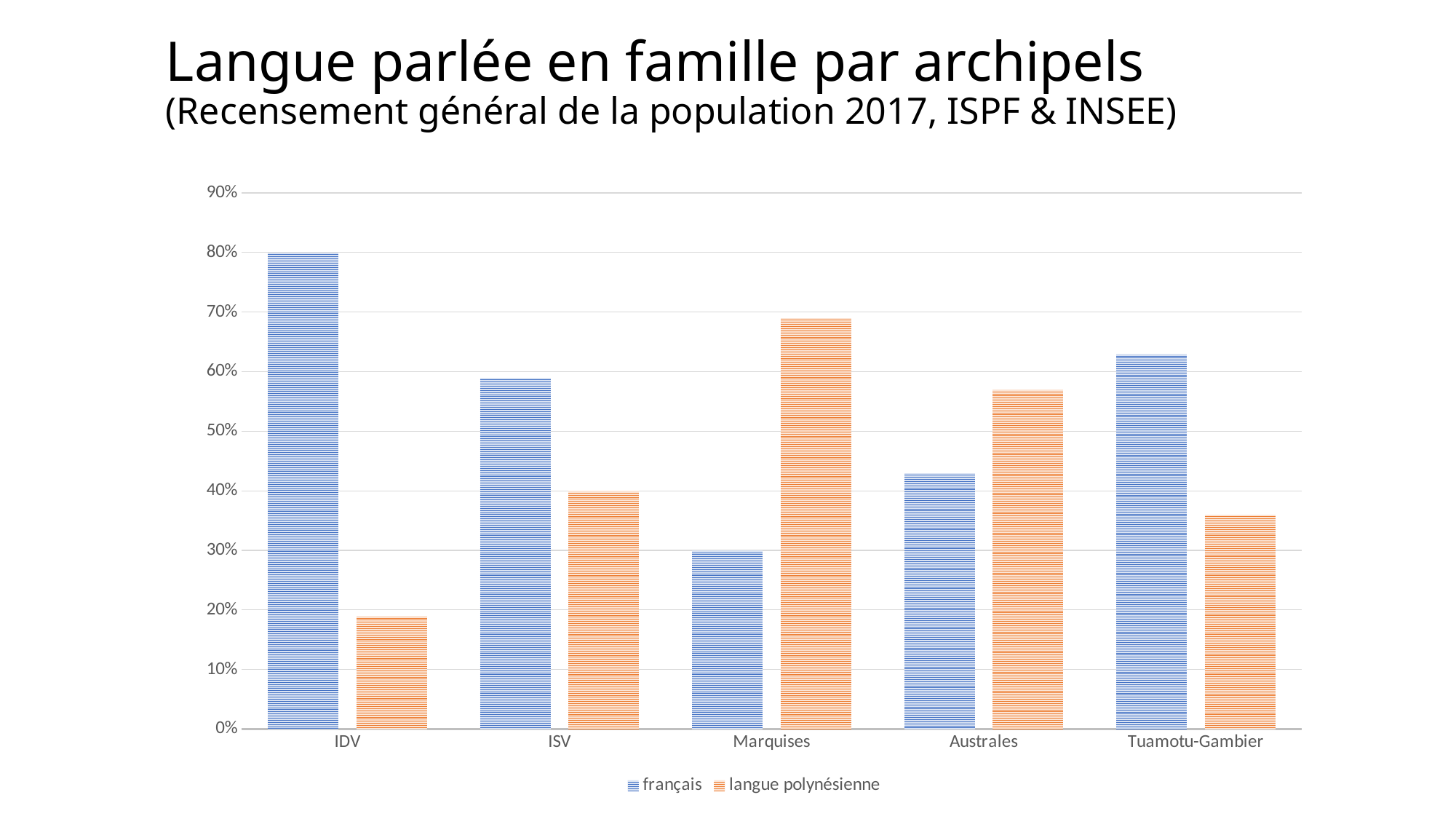
How many archipelago categories are shown on the x axis? 5 Which archipelago has the lowest value for français? Marquises What kind of chart is shown on the slide? bar chart How many series does the legend list? 2 Which archipelago has the highest value for français? IDV In ISV, which is larger: français or langue polynésienne? français Which archipelago has the highest value for langue polynésienne? Marquises Is the value for langue polynésienne in IDV greater or less than 20%? less In Australes, which is larger: français or langue polynésienne? langue polynésienne Which archipelago has the lowest value for langue polynésienne? IDV Which series is shown in orange in the legend? langue polynésienne Is the value for français in Tuamotu-Gambier greater or less than 60%? greater